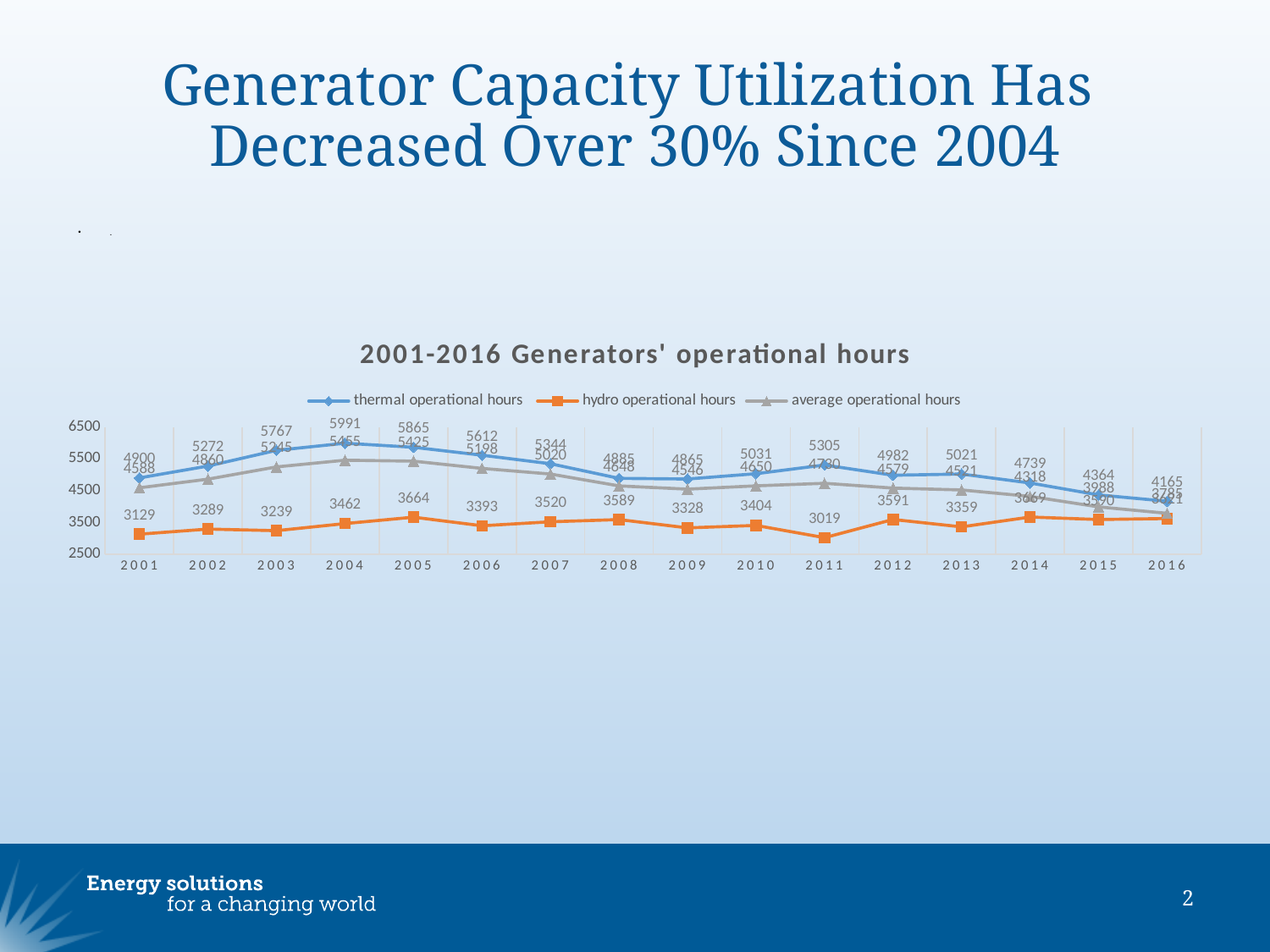
What kind of chart is shown on the slide? line chart How many years are plotted along the x axis? 16 By how much did thermal operational hours fall from 2004 to 2016? 1826 In which year were thermal operational hours highest? 2004 Is the value for hydro operational hours in 2001 greater or less than 3500? less In which year were hydro operational hours lowest? 2011 What were the thermal operational hours in 2004? 5991 What is the title of the chart? 2001-2016 Generators' operational hours What were the average operational hours in 2001? 4588 Which year had higher thermal operational hours, 2003 or 2005? 2005 How many series does the legend list? 3 What were the hydro operational hours in 2005? 3664